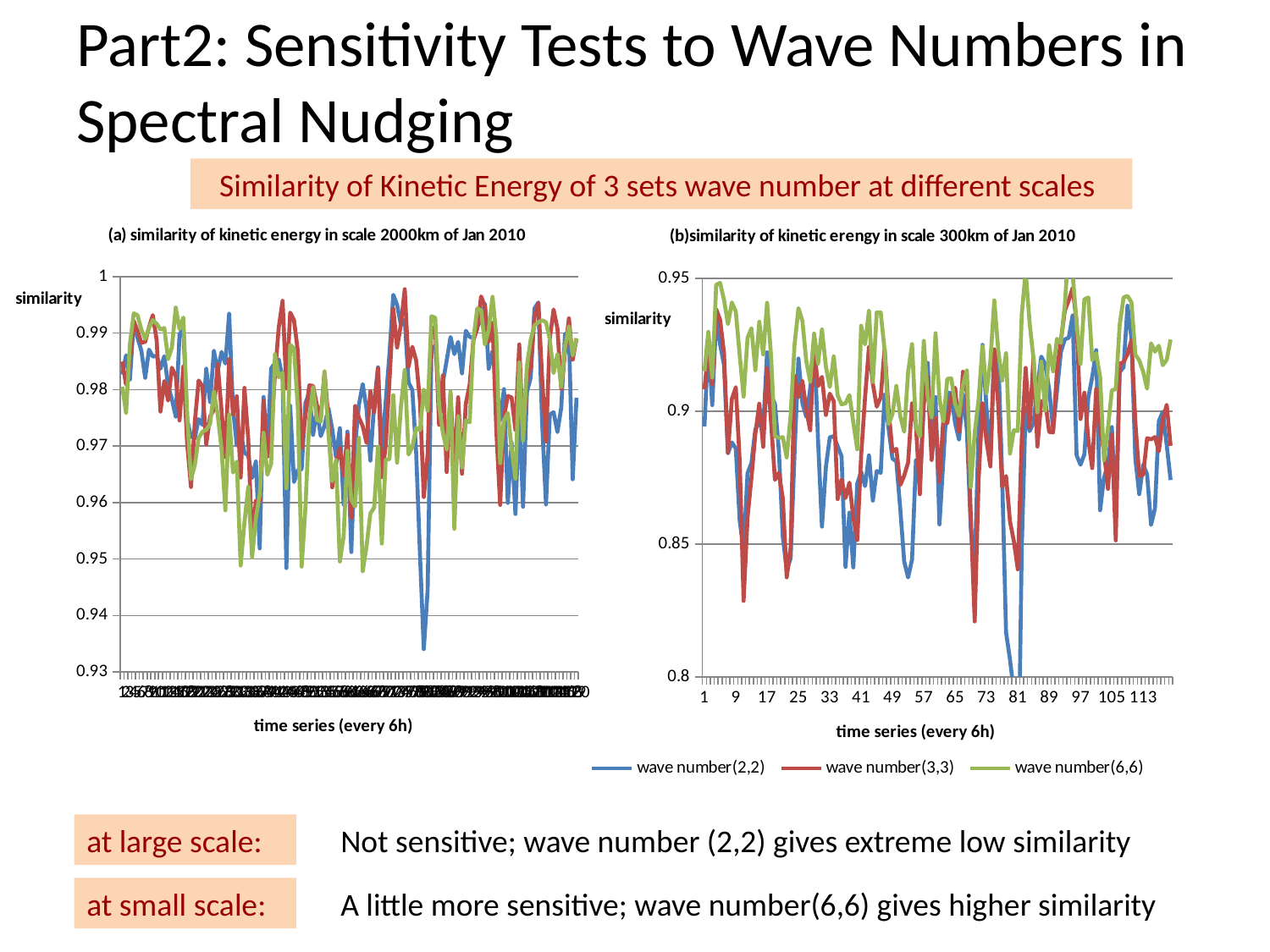
How many series does the legend list for the charts on the slide? 3 In the chart on the left (scale 2000km), is the lowest value of wave number(2,2) greater or less than 0.94? less What colour is the line for wave number(6,6) in the charts? green In the chart on the right (scale 300km), which series reaches the lowest similarity value? wave number(2,2) In the chart on the right (scale 300km), which series reaches the highest similarity value? wave number(6,6) In the chart on the right (scale 300km), is the highest value of wave number(6,6) greater or less than 0.9? greater What kind of chart is the chart titled "(a) similarity of kinetic energy in scale 2000km of Jan 2010"? line chart In the chart on the left (scale 2000km), which series reaches the lowest similarity value? wave number(2,2) What kind of chart is the chart titled "(b)similarity of kinetic erengy in scale 300km of Jan 2010"? line chart In the chart on the left (scale 2000km), is the highest value of wave number(3,3) greater or less than 0.99? greater What is the x-axis label of the chart on the right (scale 300km)? time series (every 6h)